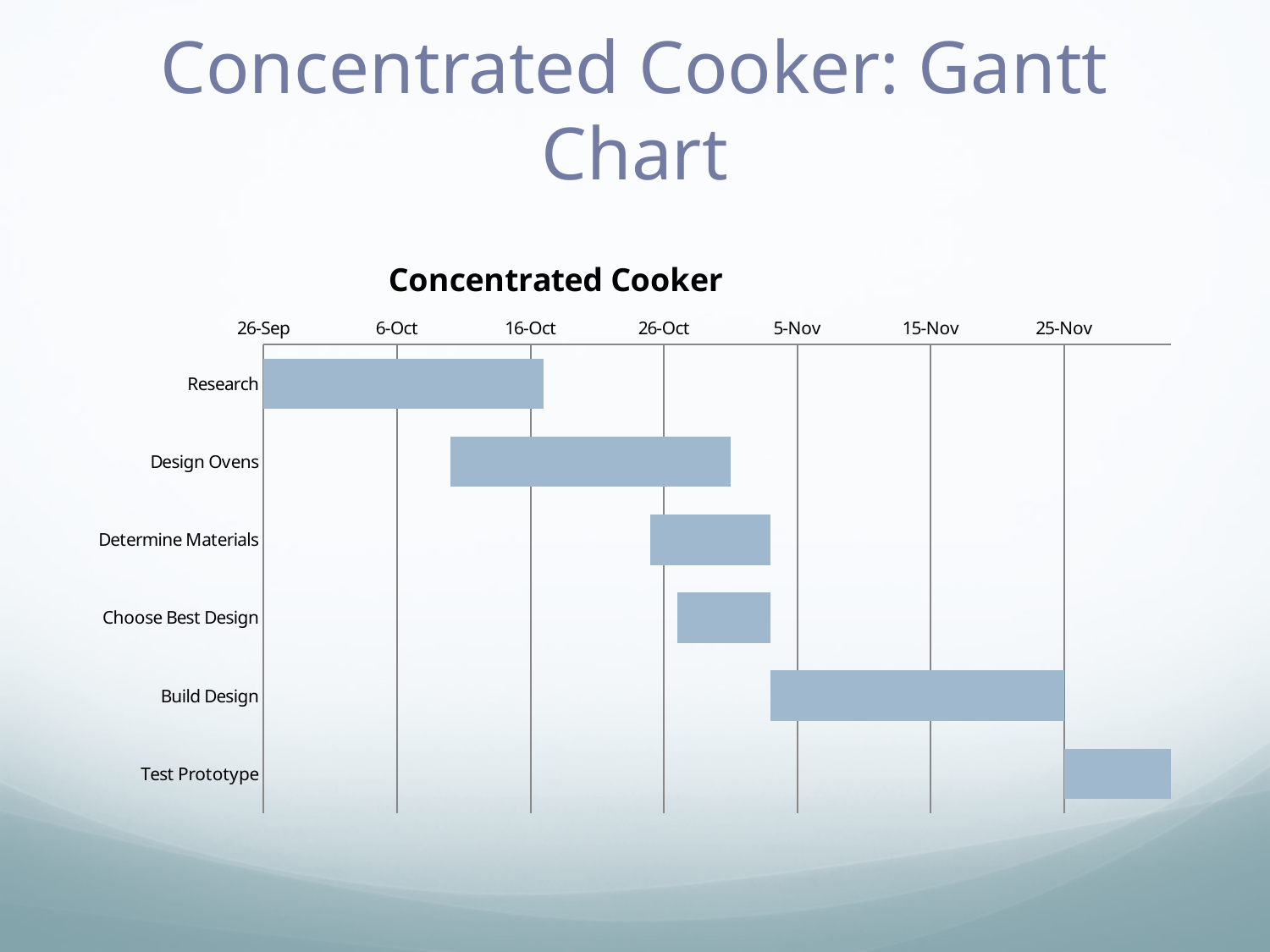
Which task ends later, Research or Design Ovens? Design Ovens Which task starts first on the chart? Research Does the Research task end before or after 16-Oct? after How many tasks are listed on the chart? 6 What is the title of the chart? Concentrated Cooker Does the Design Ovens task end before or after 5-Nov? before On what date does the Build Design task end? 25-Nov Which task starts earlier, Determine Materials or Choose Best Design? Determine Materials On what date does the Research task start? 26-Sep On what date does the Test Prototype task start? 25-Nov Which task is the last to finish on the chart? Test Prototype What kind of chart is shown on the slide? Bar chart (Gantt chart)